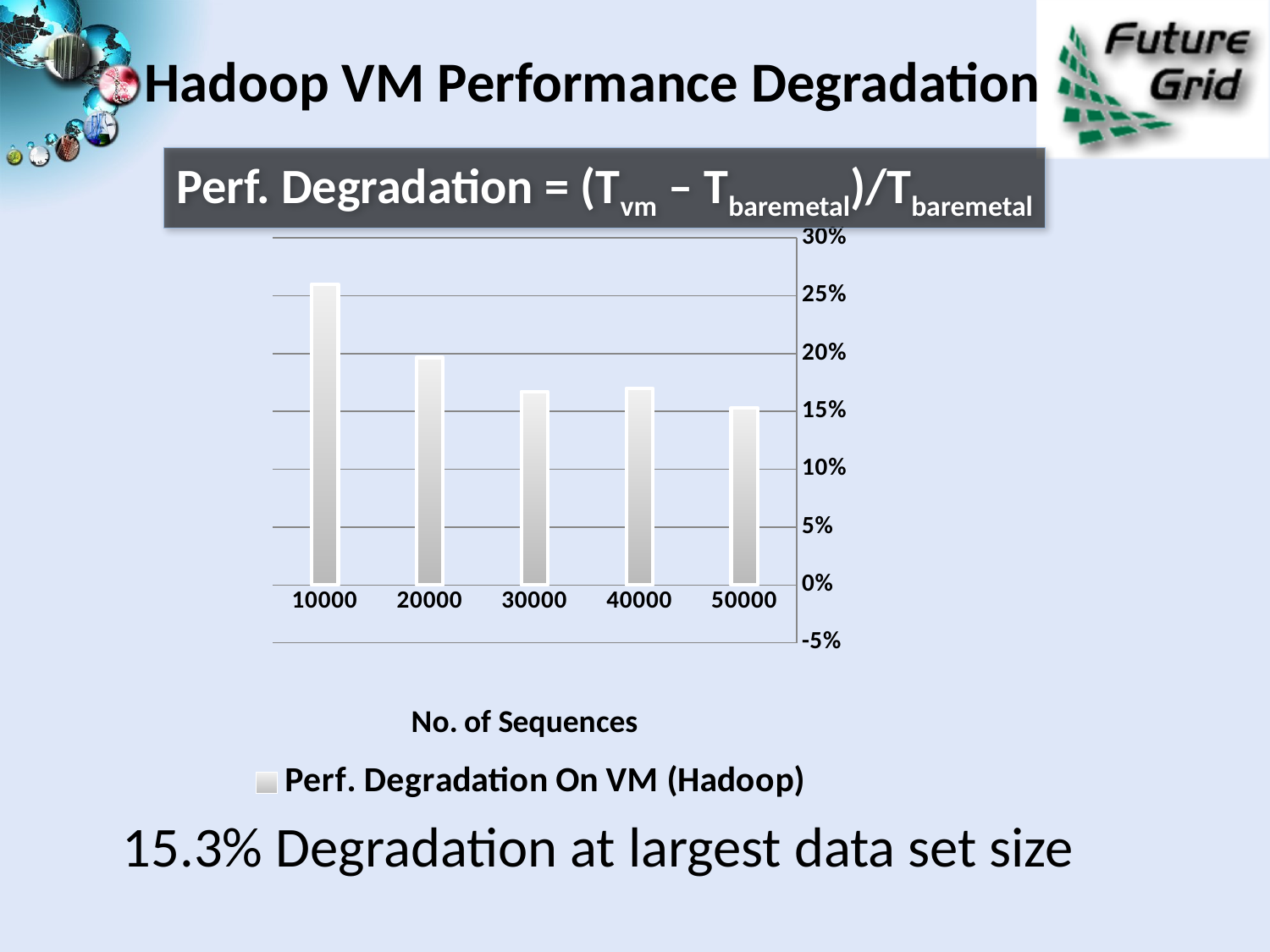
Is the value for 10000 sequences greater or less than 20%? greater How many categories (numbers of sequences) are plotted on the x axis? 5 Is the value for 20000 sequences greater or less than 25%? less Which number of sequences has the lowest performance degradation? 50000 Does the performance degradation generally rise or fall as the number of sequences increases? fall Which has the larger performance degradation, 10000 or 20000 sequences? 10000 Which number of sequences has the highest performance degradation? 10000 Is the value for 40000 sequences greater or less than 15%? greater What is the performance degradation at the largest data set size (50000 sequences)? 15.3% What kind of chart is shown on the slide? bar chart How many series does the legend list? 1